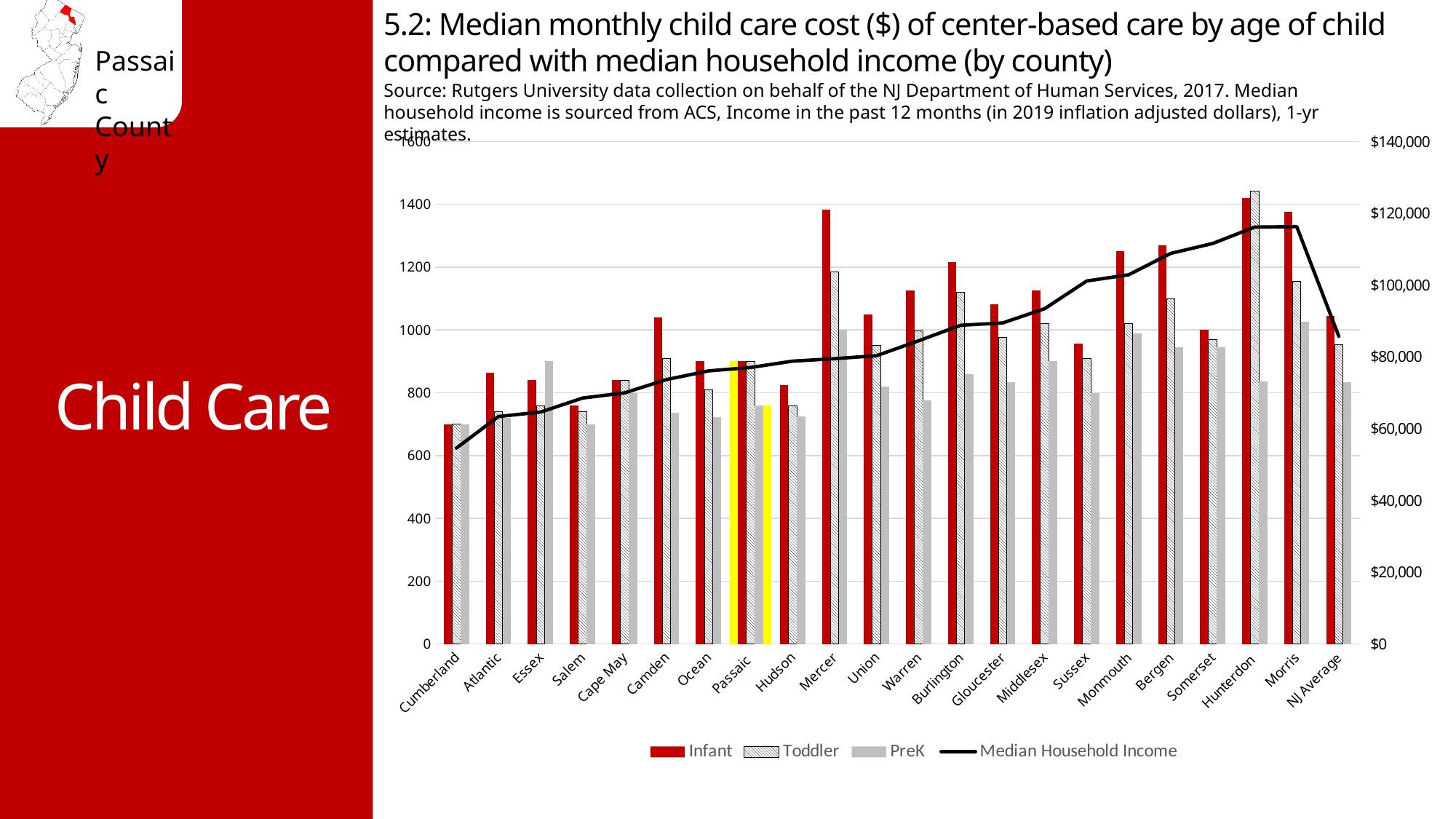
Which category has the lowest Infant bar? Cumberland Is the Infant value for Cumberland greater or less than 800? less Does the Median Household Income line generally rise or fall from Cumberland to Morris? rise Is the Median Household Income for Cumberland greater or less than $60,000? less Which category has the highest Infant bar? Hunterdon Is the Infant value for Mercer greater or less than 1200? greater Which is larger, the Infant value for Mercer or the Infant value for Union? Mercer How many counties/categories are shown along the x axis? 22 How many series does the legend list? 4 Which category has the highest Toddler bar? Hunterdon What kind of chart is shown on the slide? Bar chart with a line